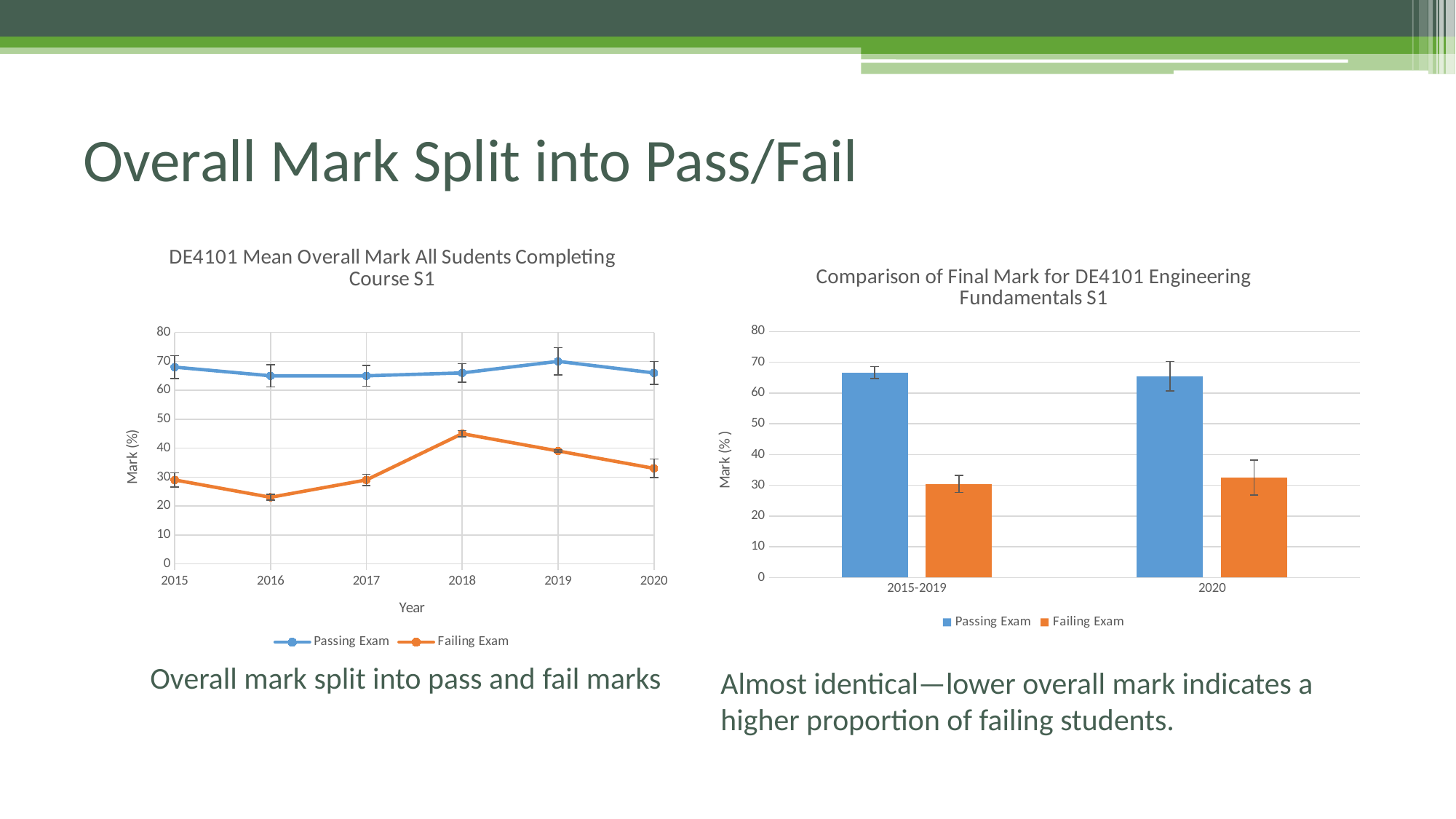
In the right chart, what is the label of the y axis? Mark (%) In the left chart, in which year is the Failing Exam value lowest? 2016 In the left chart, is the Passing Exam value for 2015 greater or less than 60? greater In the left chart, is the Failing Exam value for 2018 greater or less than 40? greater In the left chart, in which year is the Failing Exam value highest? 2018 In the left chart, which series is higher in 2020, Passing Exam or Failing Exam? Passing Exam What type of chart is the left chart titled 'DE4101 Mean Overall Mark All Sudents Completing Course S1'? line chart In the right chart, is the Passing Exam value for 2015-2019 greater or less than 60? greater What type of chart is the right chart titled 'Comparison of Final Mark for DE4101 Engineering Fundamentals S1'? bar chart In the right chart, how many categories are shown on the x axis? 2 In the left chart, how many years are plotted along the x axis? 6 In the left chart, how many series does the legend list? 2